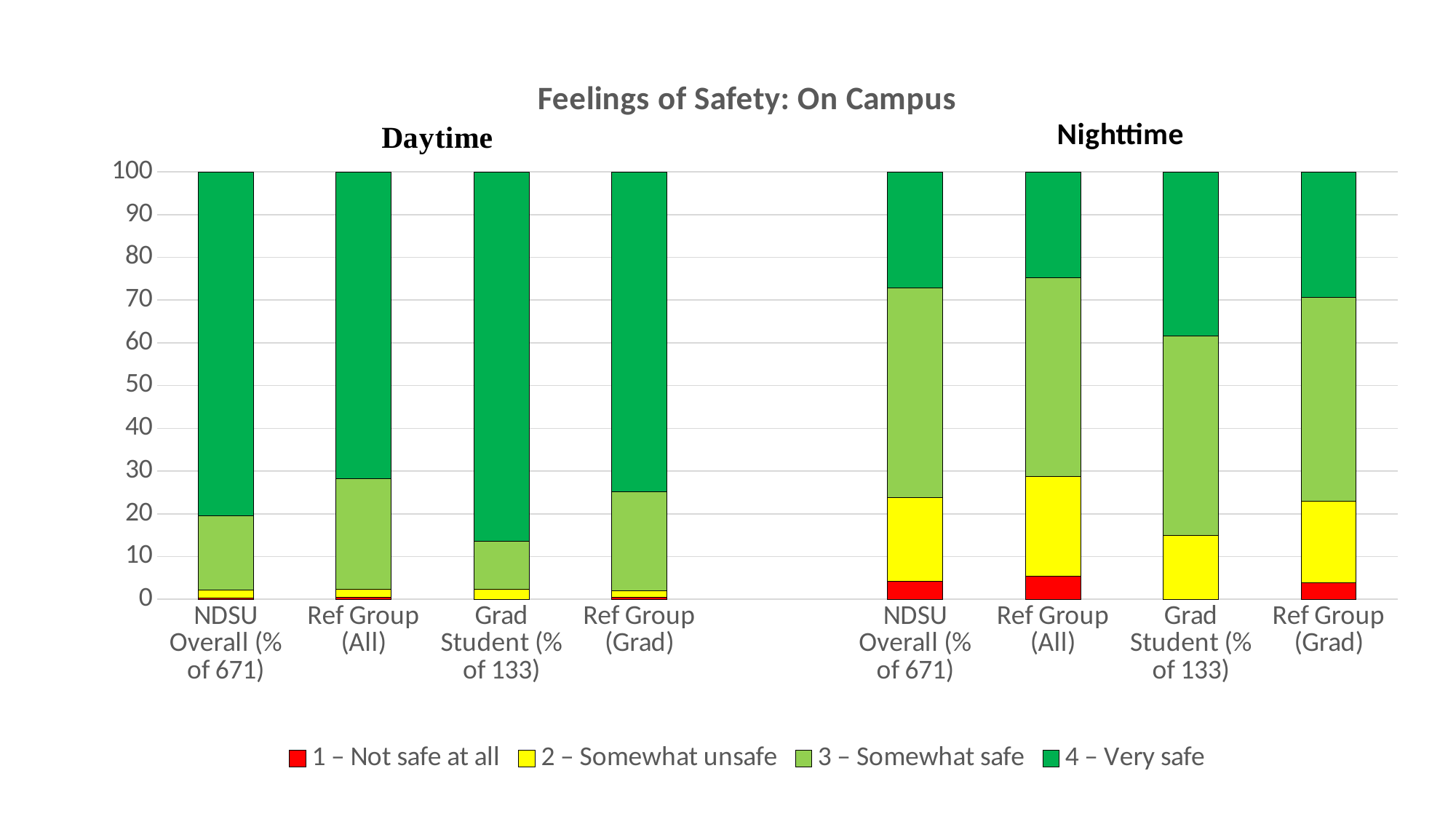
Is the '4 – Very safe' value for Daytime Grad Student (% of 133) greater or less than 80? greater What is the title of the chart? Feelings of Safety: On Campus How many bars are plotted in the chart? 8 How many series does the legend list? 4 Is the '4 – Very safe' value for Nighttime NDSU Overall (% of 671) greater or less than 30? less What is the total height of the stacked bar for Daytime NDSU Overall (% of 671)? 100 Among the Nighttime bars, which group has the smallest '1 – Not safe at all' segment? Grad Student (% of 133) In the Daytime bars, is the '4 – Very safe' segment larger for NDSU Overall (% of 671) or for Ref Group (All)? NDSU Overall (% of 671) Among the Nighttime bars, which group has the largest '4 – Very safe' segment? Grad Student (% of 133) Which colour represents the '1 – Not safe at all' series? Red What kind of chart is shown on the slide? Stacked bar chart Which bar has the largest '4 – Very safe' segment overall? Daytime Grad Student (% of 133)